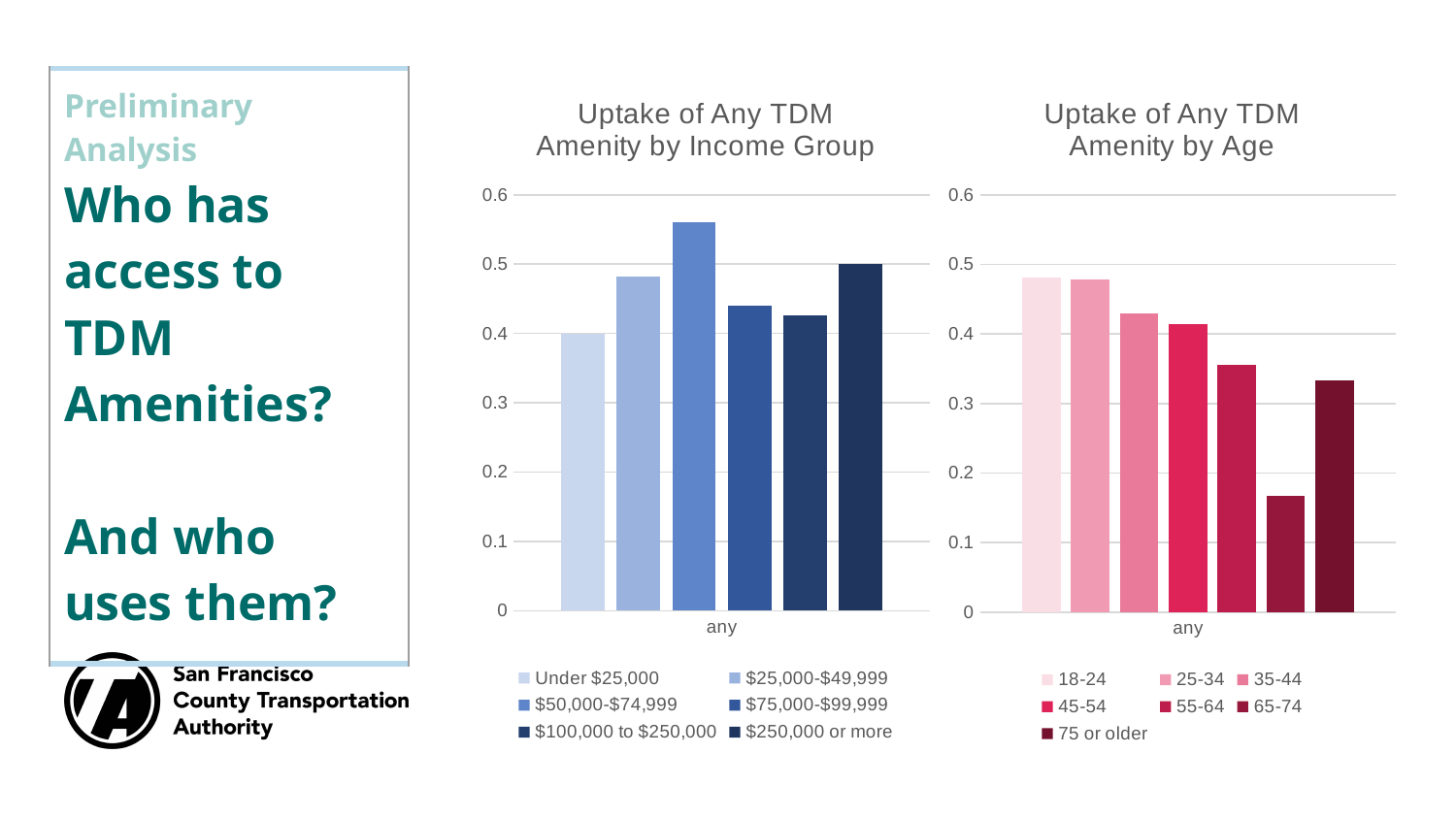
In the 'Uptake of Any TDM Amenity by Income Group' chart, which income group has the highest uptake? $50,000-$74,999 In the 'Uptake of Any TDM Amenity by Age' chart, which is larger: the value for 35-44 or the value for 55-64? 35-44 In the 'Uptake of Any TDM Amenity by Age' chart, which age group has the lowest uptake? 65-74 In the 'Uptake of Any TDM Amenity by Income Group' chart, is the value for $75,000-$99,999 greater or less than 0.5? less In the 'Uptake of Any TDM Amenity by Income Group' chart, which is larger: the value for $25,000-$49,999 or the value for $100,000 to $250,000? $25,000-$49,999 What kind of chart is the 'Uptake of Any TDM Amenity by Age' chart? bar chart How many income groups does the legend of the 'Uptake of Any TDM Amenity by Income Group' chart list? 6 In the 'Uptake of Any TDM Amenity by Age' chart, is the value for 65-74 greater or less than 0.2? less In the 'Uptake of Any TDM Amenity by Income Group' chart, which income group has the lowest uptake? Under $25,000 In the 'Uptake of Any TDM Amenity by Income Group' chart, is the value for $50,000-$74,999 greater or less than 0.5? greater How many age groups does the legend of the 'Uptake of Any TDM Amenity by Age' chart list? 7